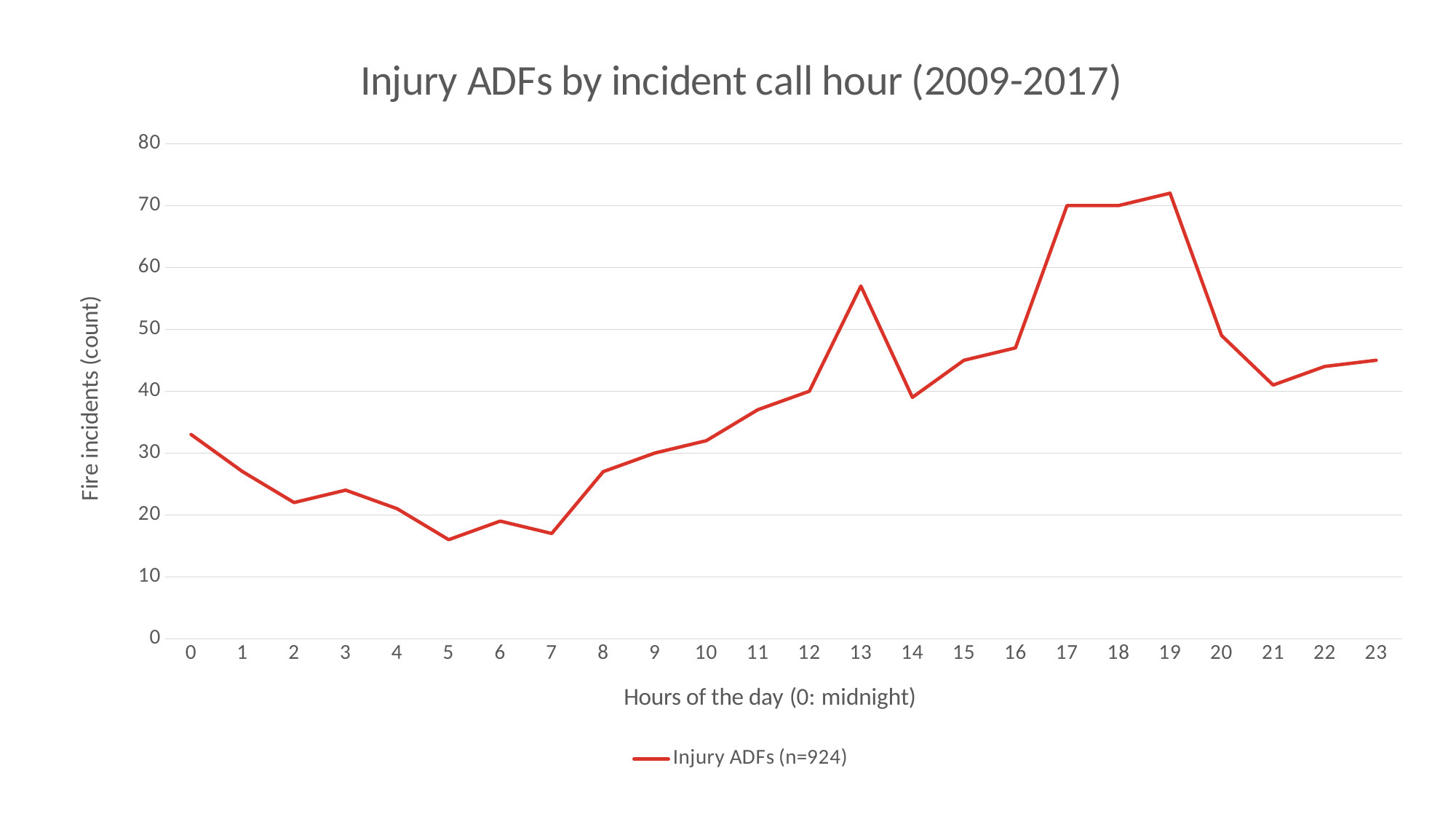
Which hour has more injury ADFs, hour 13 or hour 14? 13 Is the value for hour 0 greater or less than 30? greater How many series does the legend list? 1 Which hour has more injury ADFs, hour 2 or hour 8? 8 How many hours (data points) are plotted along the x axis? 24 What kind of chart is shown on the slide? line chart Is the value for hour 20 greater or less than 60? less Is the value for hour 13 greater or less than 50? greater Do the values rise or fall from hour 0 to hour 5? fall At which hour of the day is the number of injury ADFs highest? 19 What is the legend entry for the plotted series? Injury ADFs (n=924)